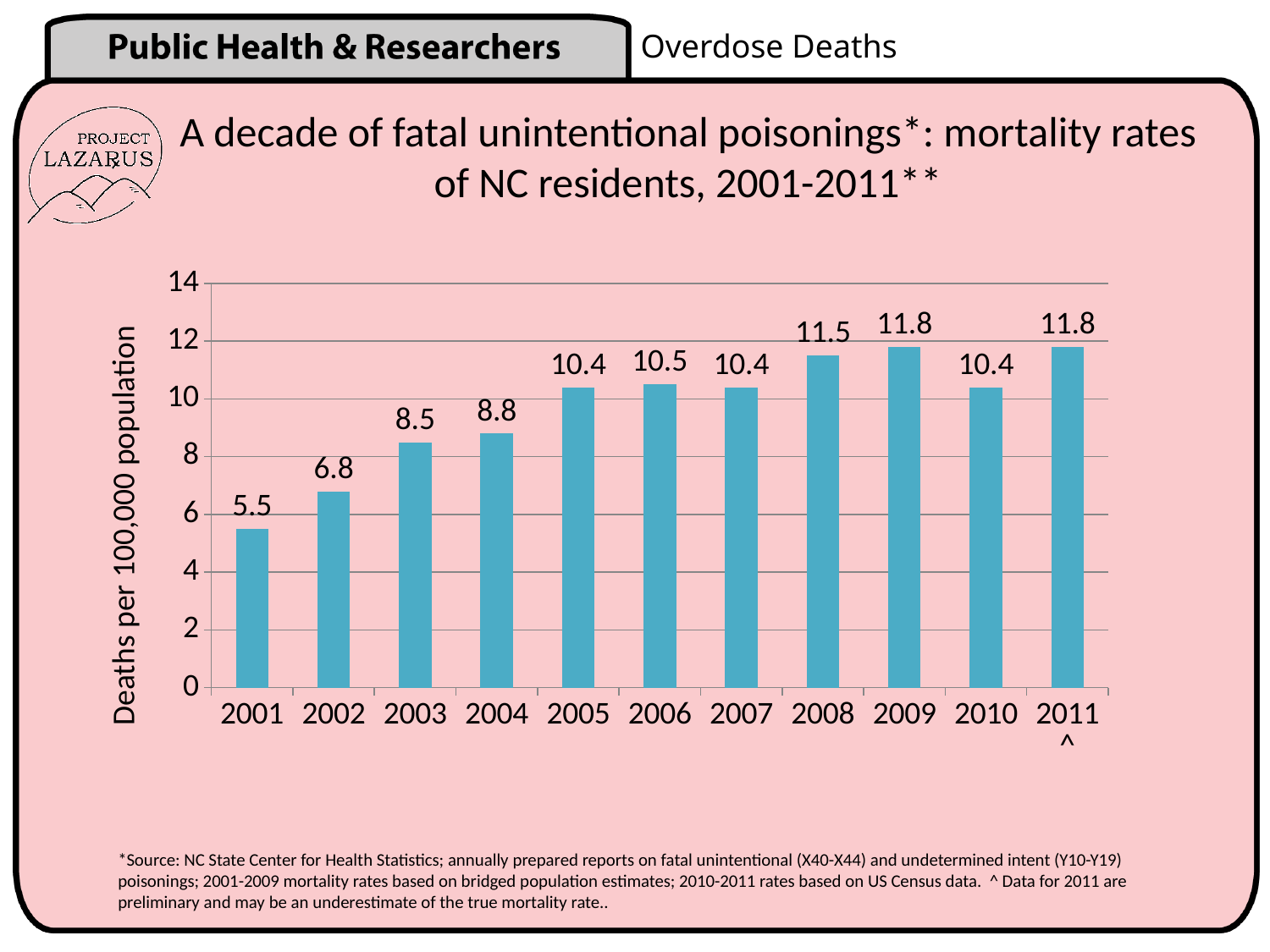
How many years are shown on the x axis? 11 What is the highest mortality rate shown on the chart? 11.8 Which year has a higher mortality rate, 2006 or 2010? 2006 What kind of chart is shown on the slide? bar chart What is the difference between the mortality rates for 2011 and 2001? 6.3 What is the difference between the mortality rates for 2003 and 2002? 1.7 What is the label of the y axis? Deaths per 100,000 population What is the mortality rate for 2001? 5.5 What is the mortality rate for 2010? 10.4 Is the value for 2004 greater or less than 10? less Which year has the lowest mortality rate? 2001 What is the mortality rate for 2008? 11.5